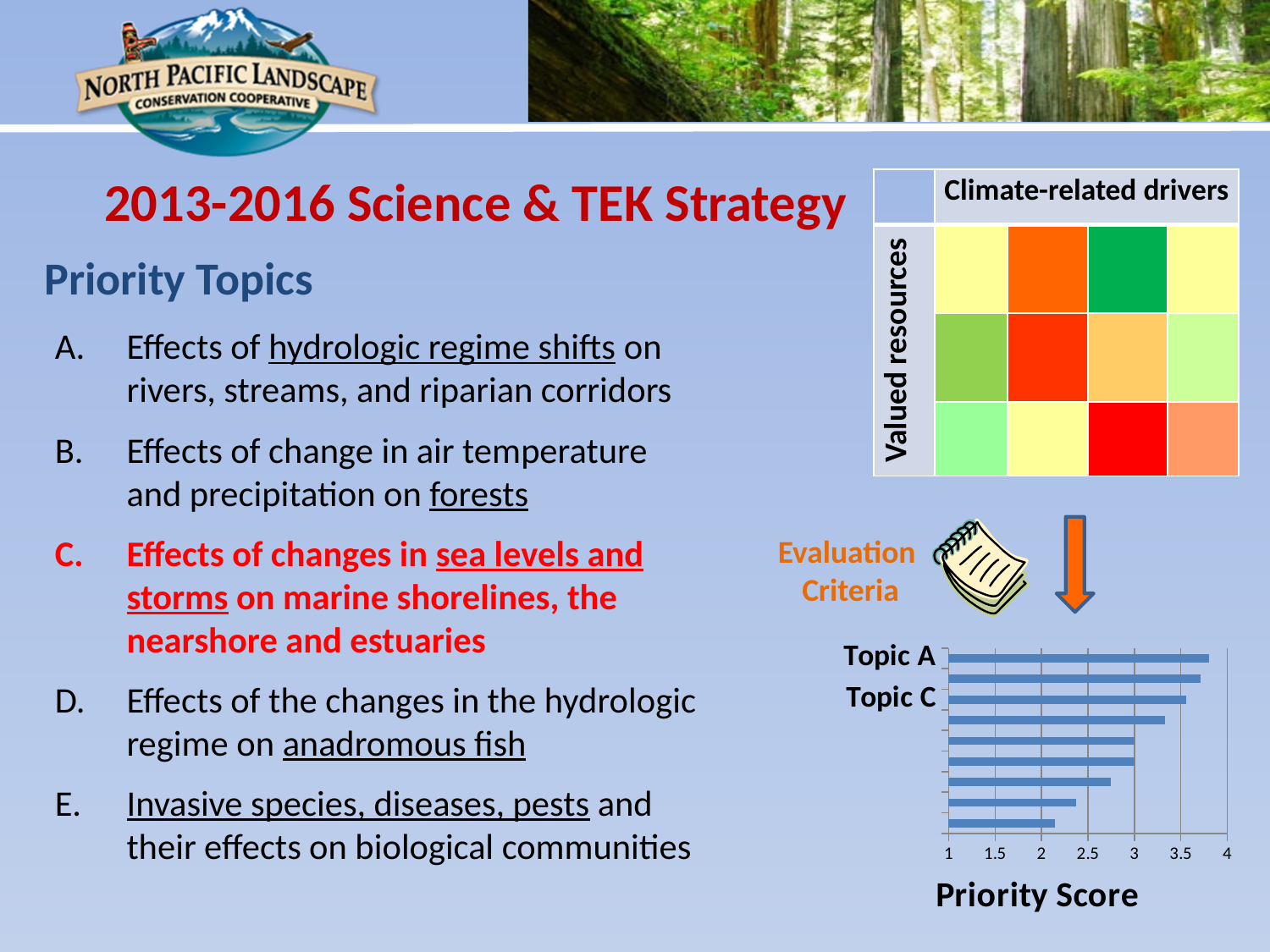
In the bar chart, what is the lowest value shown on the Priority Score axis? 1 In the bar chart, what is the highest value shown on the Priority Score axis? 4 In the bar chart, what is the title of the horizontal axis? Priority Score In the bar chart, is the value for Topic C greater or less than 3? greater What kind of chart is shown at the bottom right of the slide? bar chart In the bar chart, do the bars get shorter or longer going from the top of the chart to the bottom? shorter In the bar chart, which labeled topic has the longest bar? Topic A In the bar chart, is the value for Topic A greater or less than 3.5? greater In the bar chart, which has the higher priority score, Topic A or Topic C? Topic A